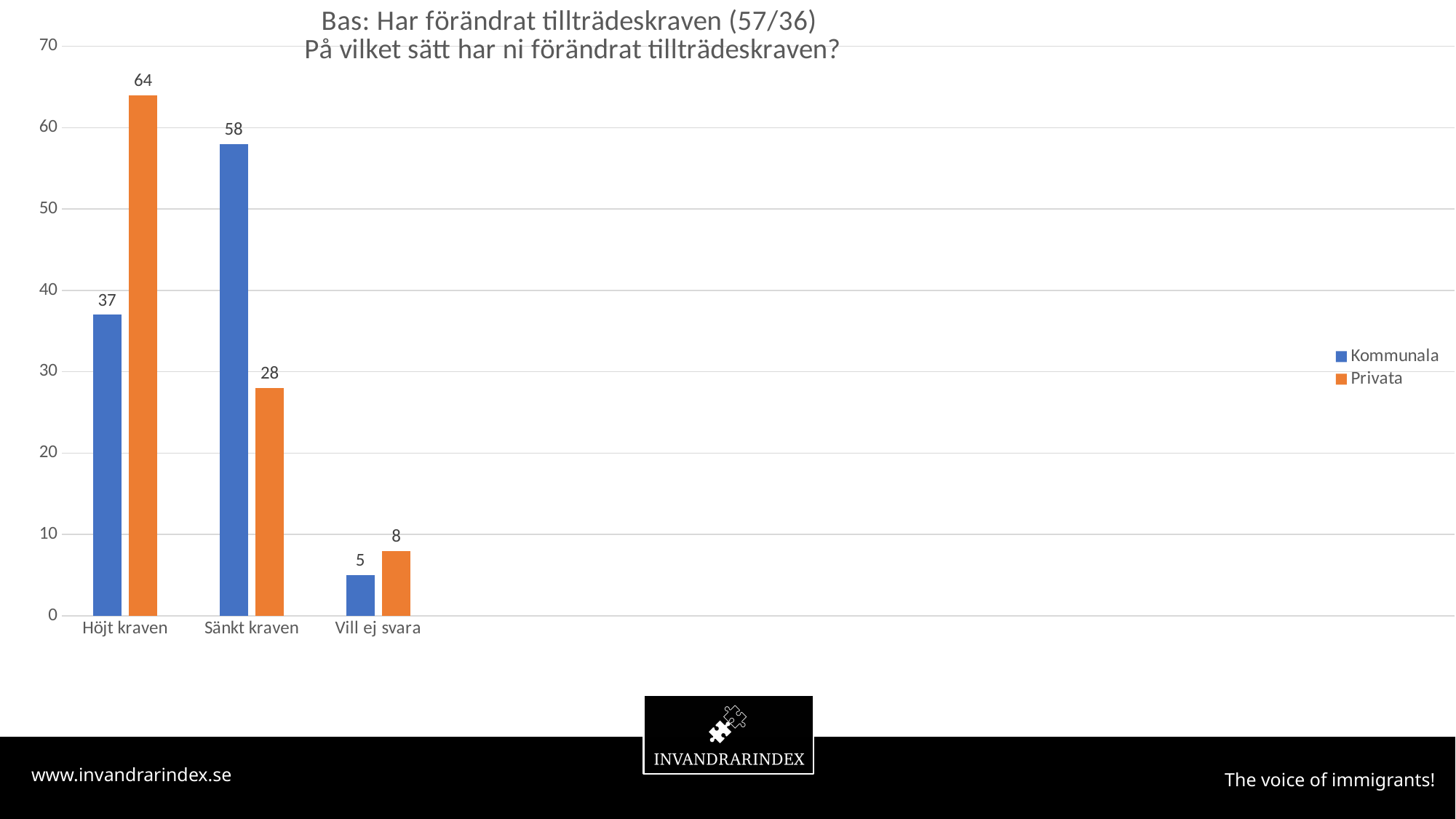
What kind of chart is shown on the slide? bar chart What is the difference between the Privata and Kommunala values for Höjt kraven? 27 Which category has the highest value for the Kommunala series? Sänkt kraven Which is larger for Sänkt kraven: Kommunala or Privata? Kommunala Is the value for Privata in Höjt kraven greater or less than 60? greater Which colour represents the Privata series? orange What is the value for Privata in the Sänkt kraven category? 28 Which category has the lowest value for the Privata series? Vill ej svara What is the value for Privata in the Vill ej svara category? 8 What is the value for Kommunala in the Höjt kraven category? 37 How many categories are shown on the x axis? 3 How many series does the legend list? 2